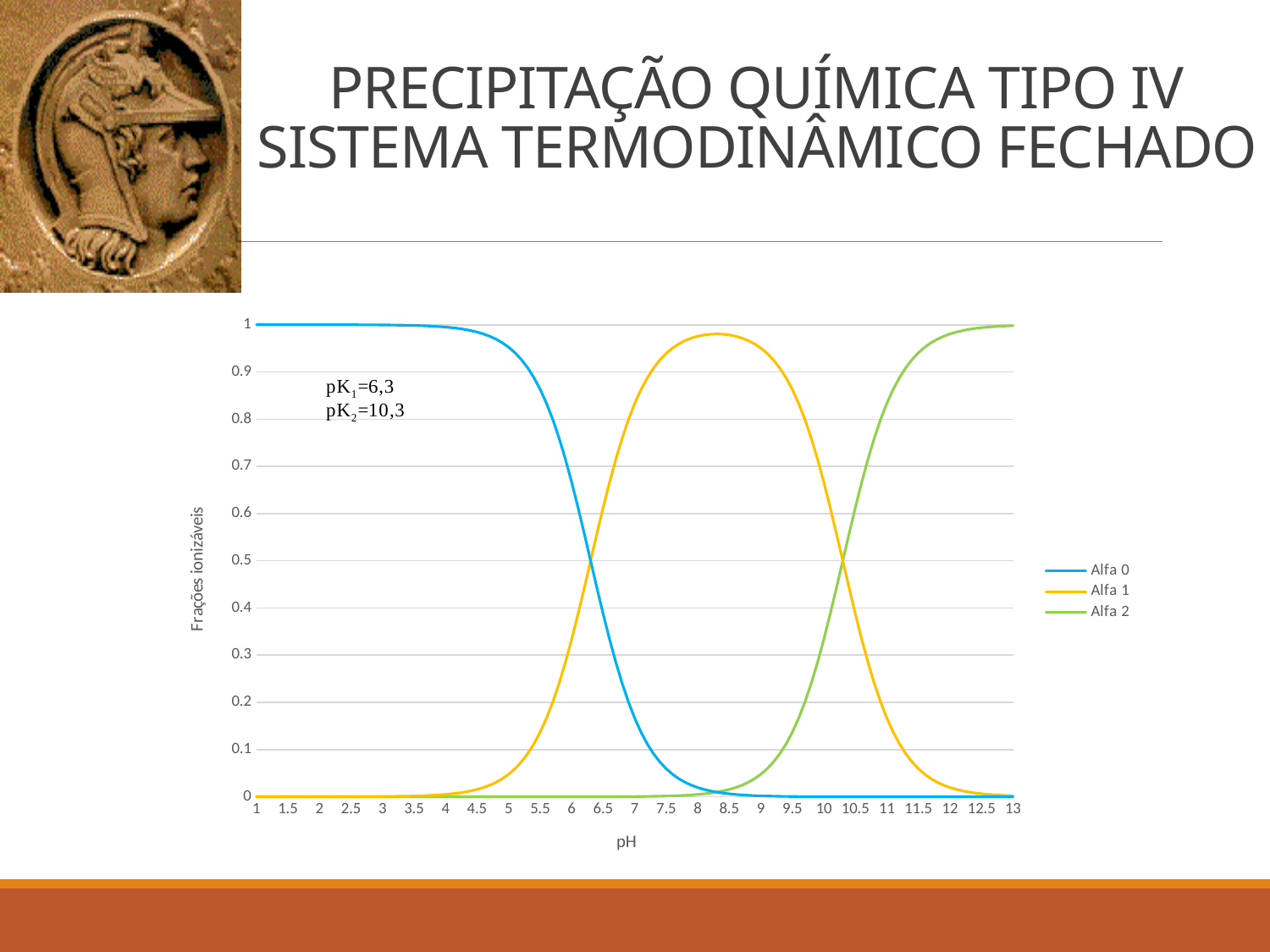
How many series does the legend list? 3 Is the value of Alfa 0 at pH 4 greater or less than 0.9? greater Does the Alfa 0 series rise or fall as pH increases? fall What is the label of the x axis? pH At pH 5, which series has the larger value, Alfa 0 or Alfa 1? Alfa 0 Which series has the highest value at pH 8? Alfa 1 What kind of chart is shown on the slide? line chart Is the value of Alfa 0 at pH 9 greater or less than 0.1? less Is the value of Alfa 1 at pH 8 greater or less than 0.9? greater Does the Alfa 2 series rise or fall as pH increases? rise What are the names of the series in the legend? Alfa 0, Alfa 1, Alfa 2